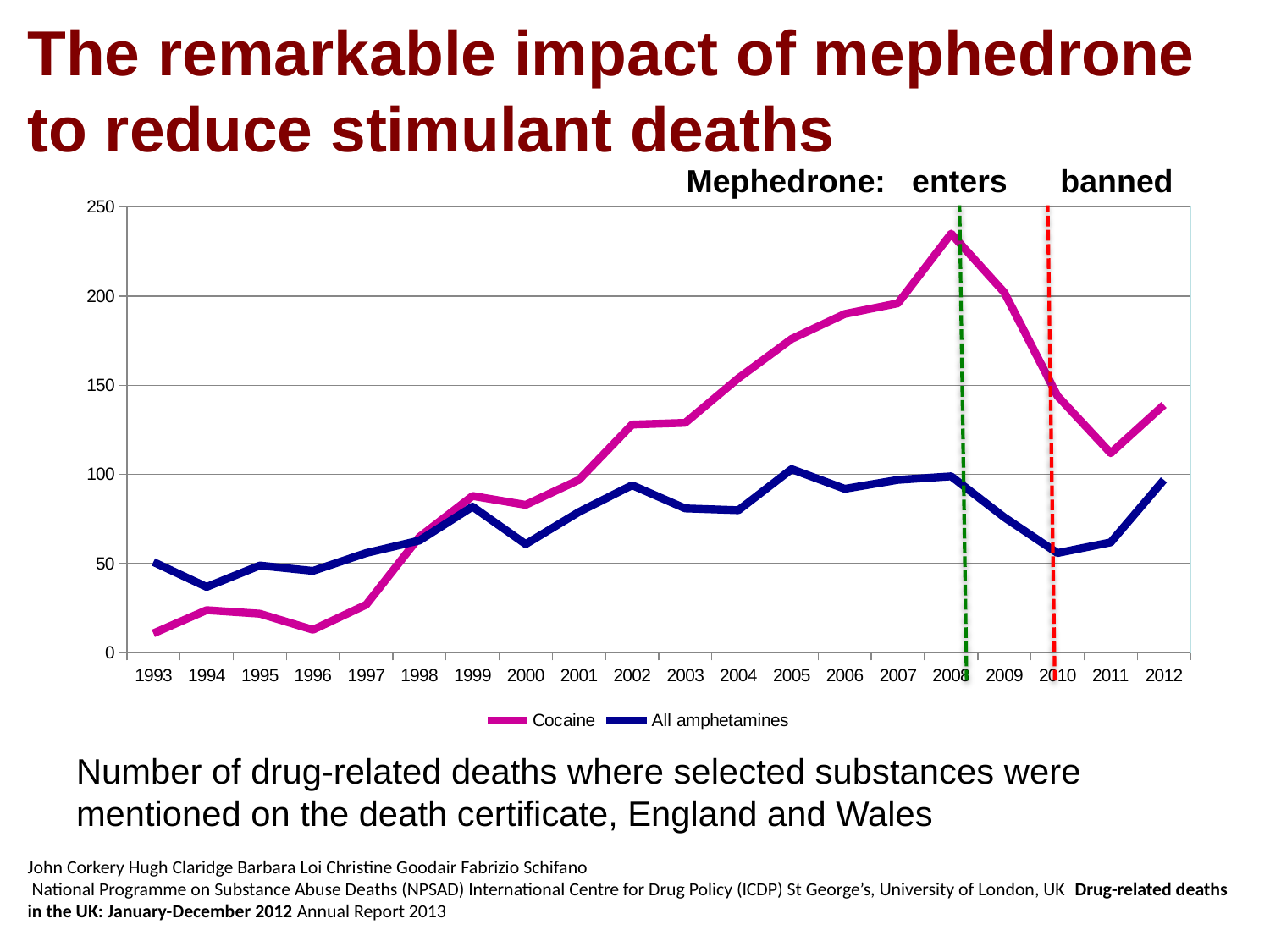
How many series does the legend list? 2 Which two series are listed in the legend? Cocaine and All amphetamines Is the Cocaine value for 2005 greater or less than 150? greater In 2008, which series has the higher value, Cocaine or All amphetamines? Cocaine How many years are shown on the x axis? 20 In 1993, which series has the higher value, Cocaine or All amphetamines? All amphetamines In which year is the Cocaine line at its lowest value? 1993 In which year does the Cocaine line reach its highest value? 2008 Is the Cocaine value for 2008 greater or less than 200? greater Is the All amphetamines value for 2010 greater or less than 100? less What kind of chart is shown on the slide? line chart